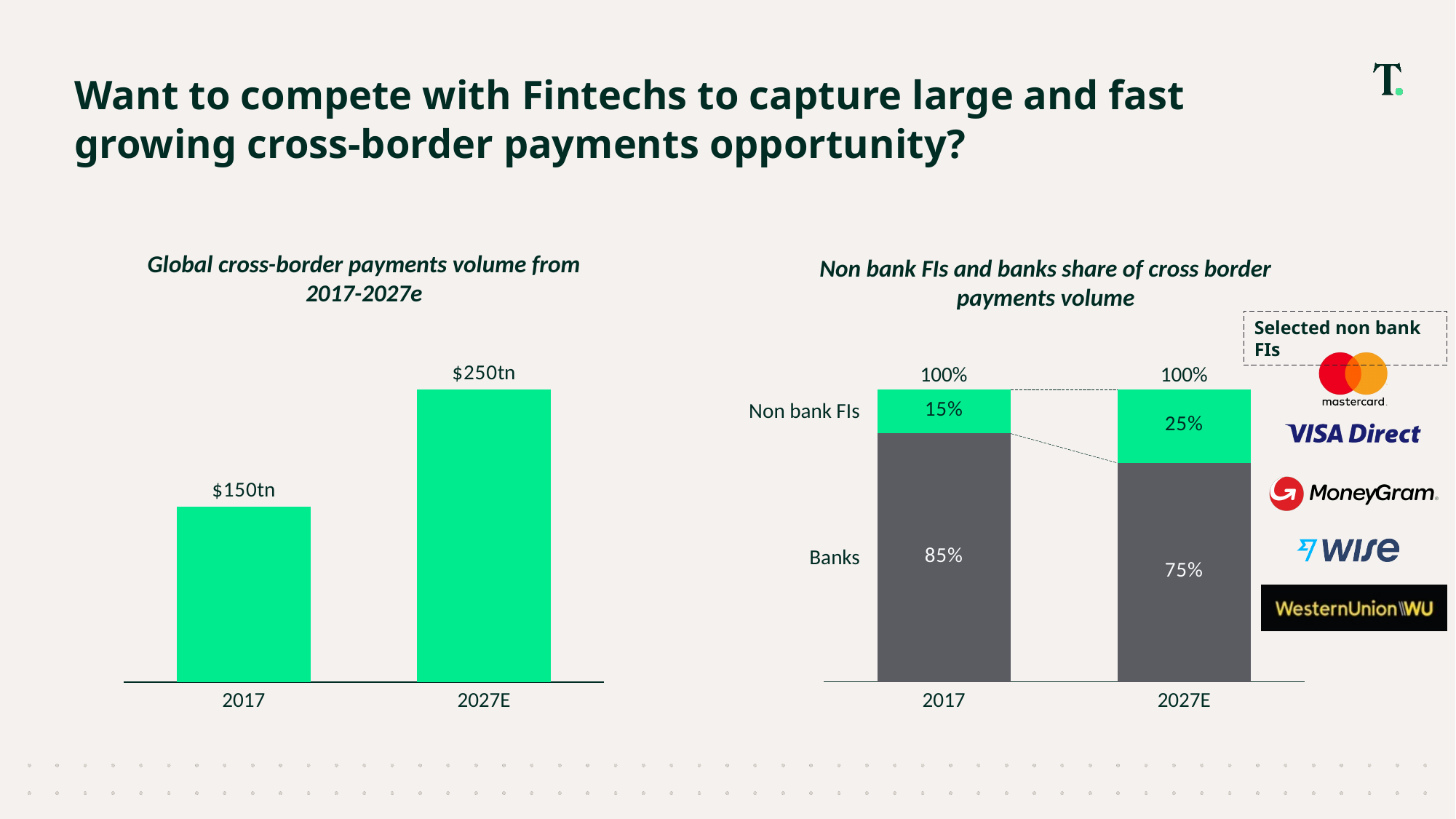
In the 'Non bank FIs and banks share of cross border payments volume' chart, what is the Banks share in 2027E? 75% In the 'Global cross-border payments volume from 2017-2027e' chart, how many bars are plotted? 2 In the 'Global cross-border payments volume from 2017-2027e' chart, what is the value for 2027E? $250tn What kind of chart is the 'Global cross-border payments volume from 2017-2027e' chart? Bar chart In the 'Non bank FIs and banks share of cross border payments volume' chart, what is the Non bank FIs share in 2017? 15% In the 'Global cross-border payments volume from 2017-2027e' chart, which year has the higher value? 2027E In the 'Non bank FIs and banks share of cross border payments volume' chart, by how many percentage points does the Non bank FIs share change from 2017 to 2027E? 10 percentage points In the 'Global cross-border payments volume from 2017-2027e' chart, what is the value for 2017? $150tn In the 'Non bank FIs and banks share of cross border payments volume' chart, does the Banks share rise or fall from 2017 to 2027E? Fall In the 'Non bank FIs and banks share of cross border payments volume' chart, what is the total of the stacked bar for 2027E? 100% In the 'Global cross-border payments volume from 2017-2027e' chart, what is the difference between the 2027E and 2017 values? $100tn In the 'Non bank FIs and banks share of cross border payments volume' chart, how many series are shown in the stacked bars? 2